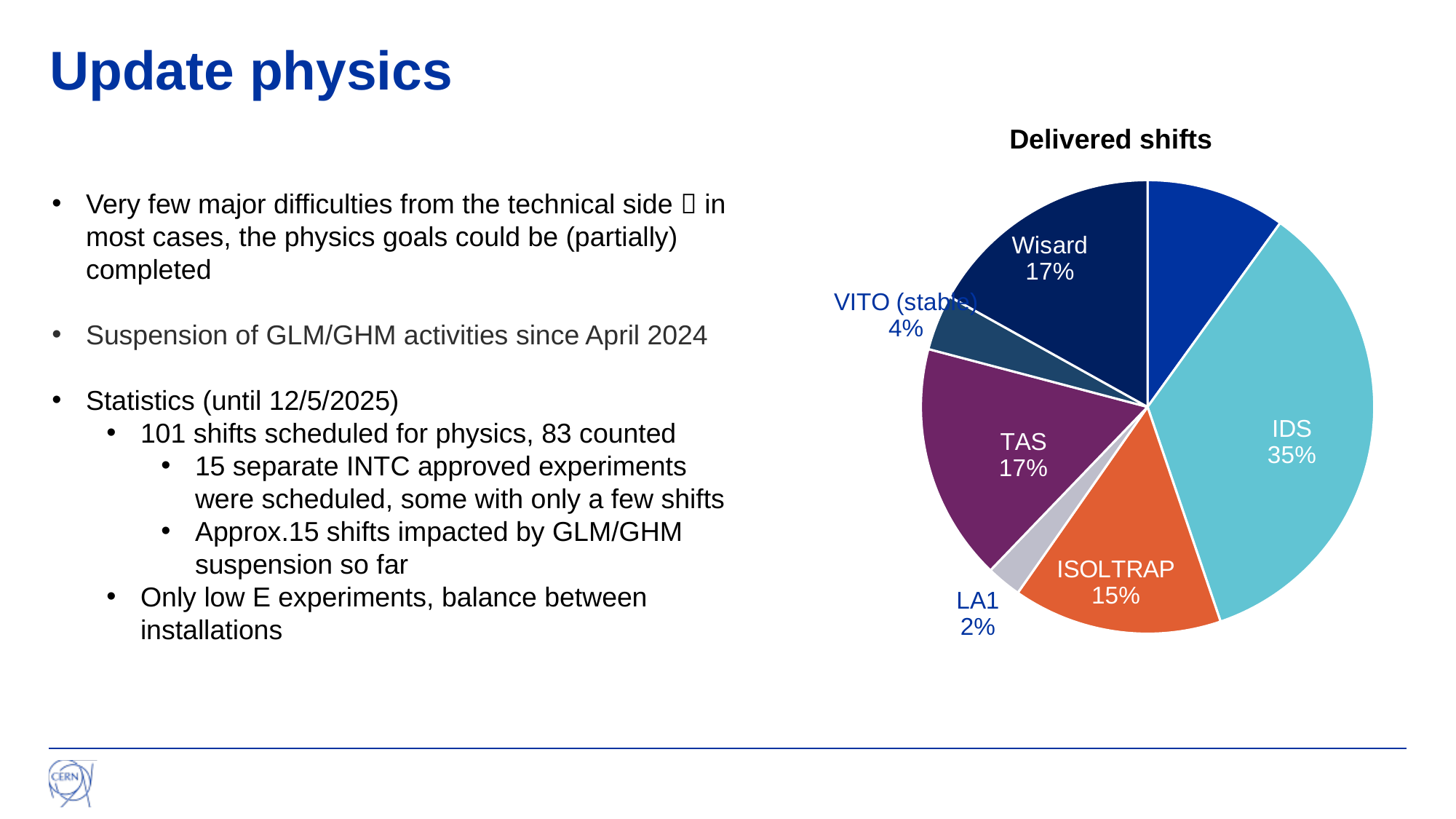
Which installation has the largest share of delivered shifts? IDS What percentage is shown for LA1? 2% What percentage is shown for VITO (stable)? 4% How many slices of the pie chart have a printed label? 6 What is the title of the chart? Delivered shifts Which labelled installation has the smallest share of delivered shifts? LA1 What type of chart is shown on the slide? pie chart What share of delivered shifts does IDS account for? 35% What percentage is shown for TAS? 17% How many percentage points larger is the IDS share than the ISOLTRAP share? 20 What percentage is shown for ISOLTRAP? 15% Which has a larger share of delivered shifts, ISOLTRAP or Wisard? Wisard